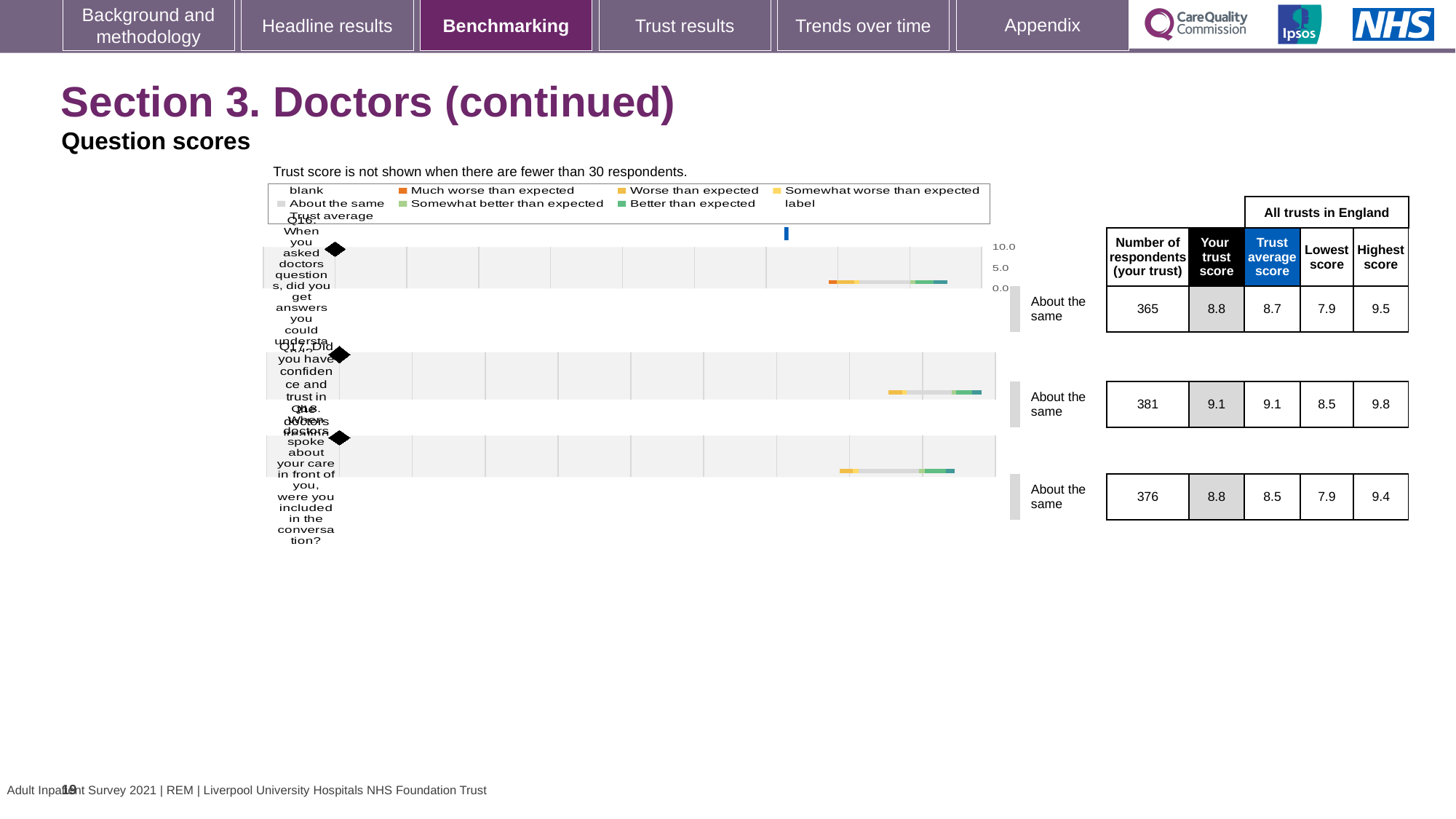
What is the lowest score across all trusts in England for Q16? 7.9 What is the difference between the highest and lowest scores for Q17? 1.3 How many respondents from your trust answered Q16 (When you asked doctors questions, did you get answers you could understand)? 365 What is the highest score across all trusts in England for Q17? 9.8 What is your trust score for Q17 (Did you have confidence and trust in the doctors treating you)? 9.1 Which question had more respondents from your trust, Q16 or Q17? Q17 What is the trust average score for Q18 (When doctors spoke about your care in front of you, were you included in the conversation)? 8.5 Which question has the highest 'Your trust score'? Q17 How many questions are plotted in the chart? 3 What is the difference between your trust score and the trust average score for Q18? 0.3 Is your trust score for Q16 greater or less than 5.0? greater What benchmark category is shown for Q16? About the same